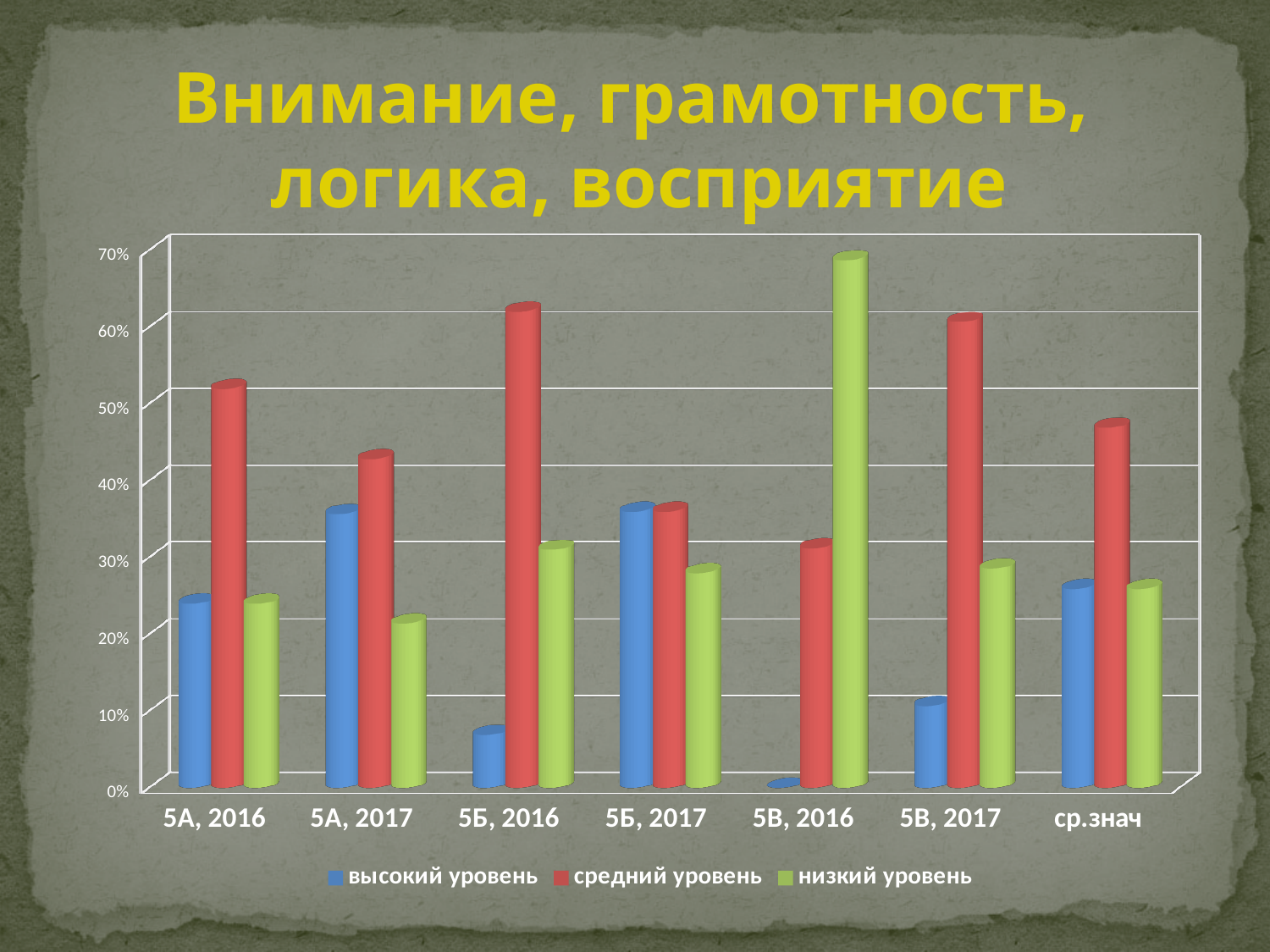
Which category has the lowest value for высокий уровень? 5В, 2016 What colour represents низкий уровень in the chart's legend? green What kind of chart is shown on the slide? bar chart Is the value for низкий уровень in 5В, 2016 greater or less than 60%? greater Is the value for средний уровень in 5Б, 2016 greater or less than 50%? greater Is the value for высокий уровень in 5Б, 2016 greater or less than 10%? less Which category has the highest value for низкий уровень? 5В, 2016 Which is larger: средний уровень for 5А, 2016 or средний уровень for 5А, 2017? 5А, 2016 In the category 5В, 2016, which is larger: средний уровень or низкий уровень? низкий уровень How many categories are shown along the x axis of the chart? 7 How many series does the chart's legend list? 3